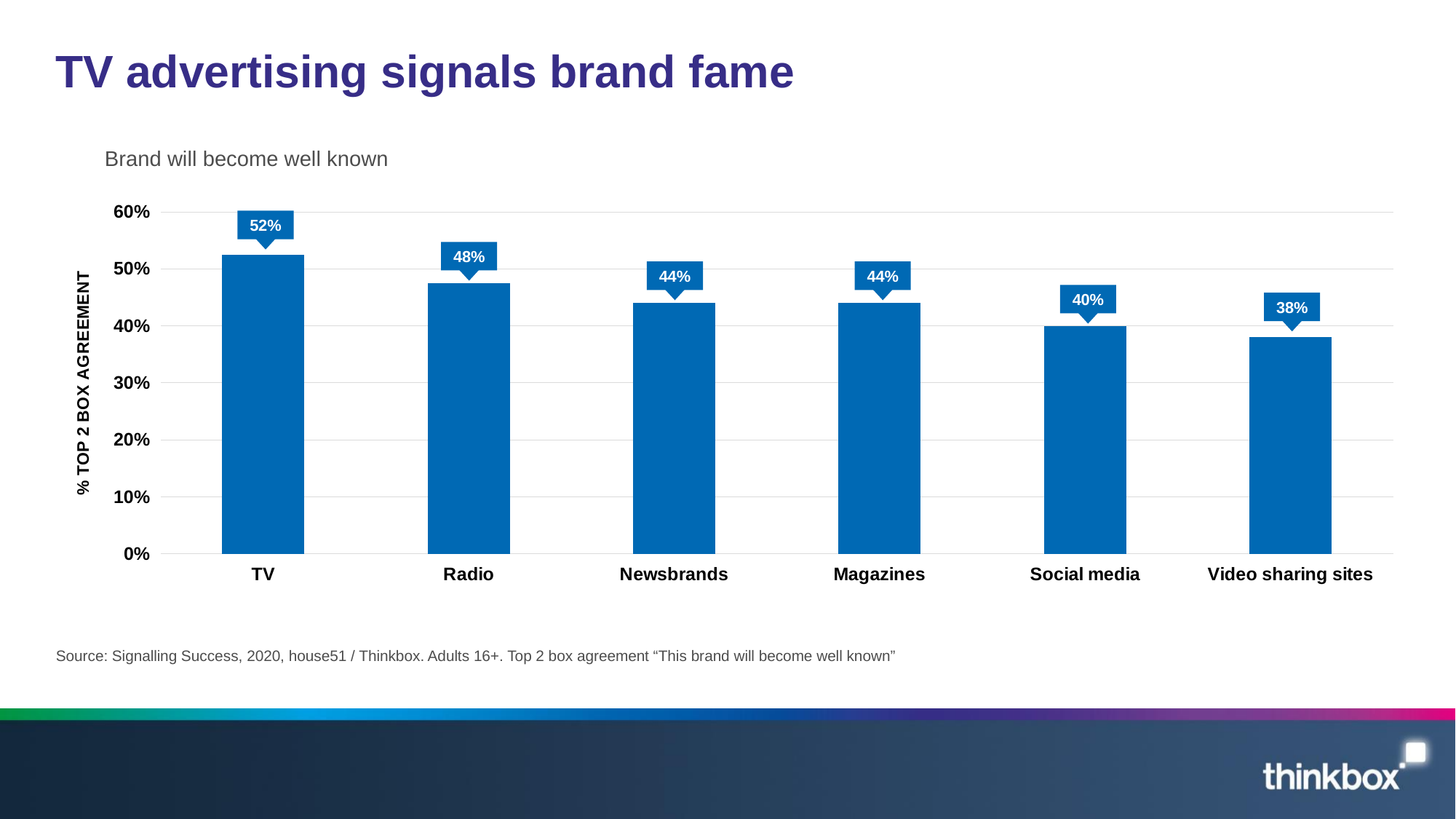
How many categories are shown on the x axis? 6 Which category has the highest value? TV Which is larger, the value for Radio or the value for Social media? Radio What is the difference between the values for TV and Radio? 4% Which category has the lowest value? Video sharing sites What is the value for Video sharing sites? 38% What is the value for Radio? 48% What kind of chart is shown on the slide? Bar chart What is the label on the vertical axis? % TOP 2 BOX AGREEMENT What is the difference between the values for Newsbrands and Video sharing sites? 6% What is the value for Social media? 40% What is the value for TV? 52%